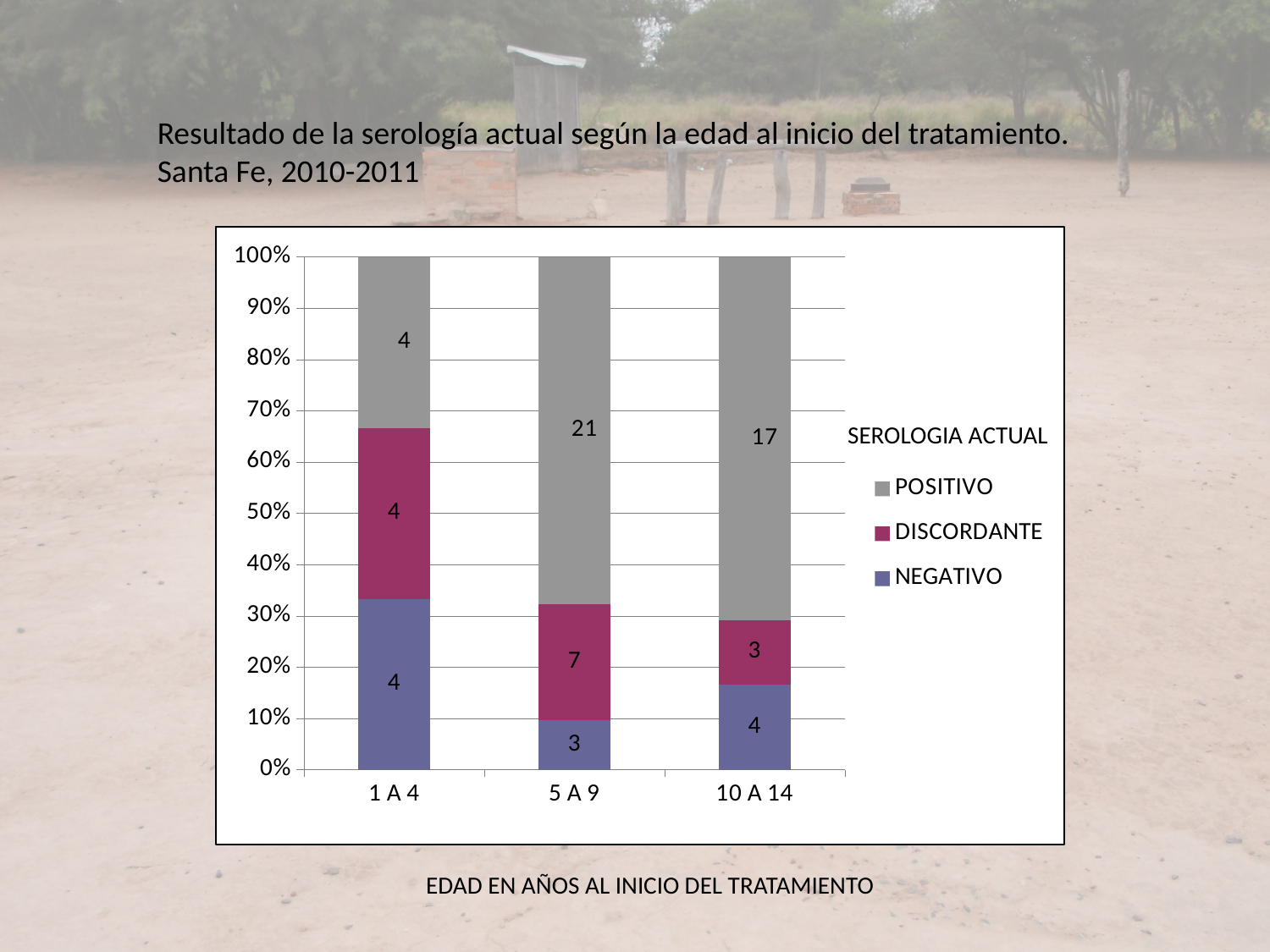
What is the x-axis label shown below the chart? EDAD EN AÑOS AL INICIO DEL TRATAMIENTO Which is larger, the DISCORDANTE value for 5 A 9 or for 1 A 4? 5 A 9 What is the DISCORDANTE value for the 10 A 14 age group? 3 Which age group has the highest POSITIVO value? 5 A 9 How many age categories are shown on the x axis? 3 Which age group has the lowest DISCORDANTE value? 10 A 14 How many series does the legend list? 3 What is the NEGATIVO value for the 1 A 4 age group? 4 What kind of chart is shown on the slide? stacked bar chart What is the POSITIVO value for the 5 A 9 age group? 21 What is the difference between the POSITIVO values for 5 A 9 and 10 A 14? 4 What is the total of the three labelled values in the 5 A 9 bar? 31